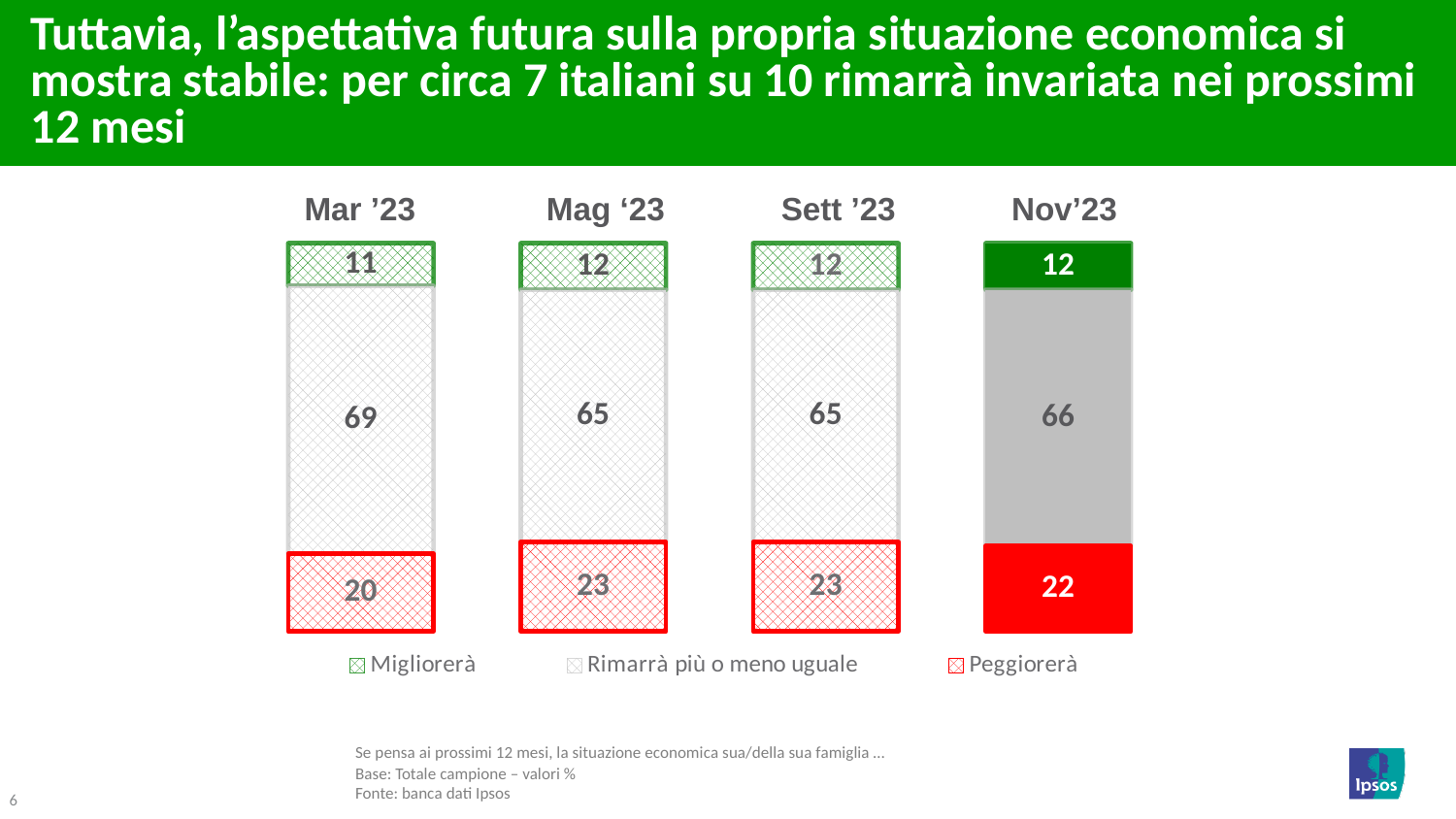
What is the difference between the "Peggiorerà" values for Mag '23 and Mar '23? 3 In which period is the value for "Migliorerà" lowest? Mar '23 How many periods are shown on the x axis? 4 What is the value for "Migliorerà" in Mag '23? 12 What is the value for "Rimarrà più o meno uguale" in Mar '23? 69 What kind of chart is shown on the slide? Stacked bar chart In which period is the value for "Rimarrà più o meno uguale" highest? Mar '23 Which is larger: the "Peggiorerà" value in Sett '23 or in Nov'23? Sett '23 Which legend entry is shown in red? Peggiorerà What is the value for "Peggiorerà" in Nov'23? 22 What is the total of the stacked bar for Nov'23? 100 How many series does the legend list? 3